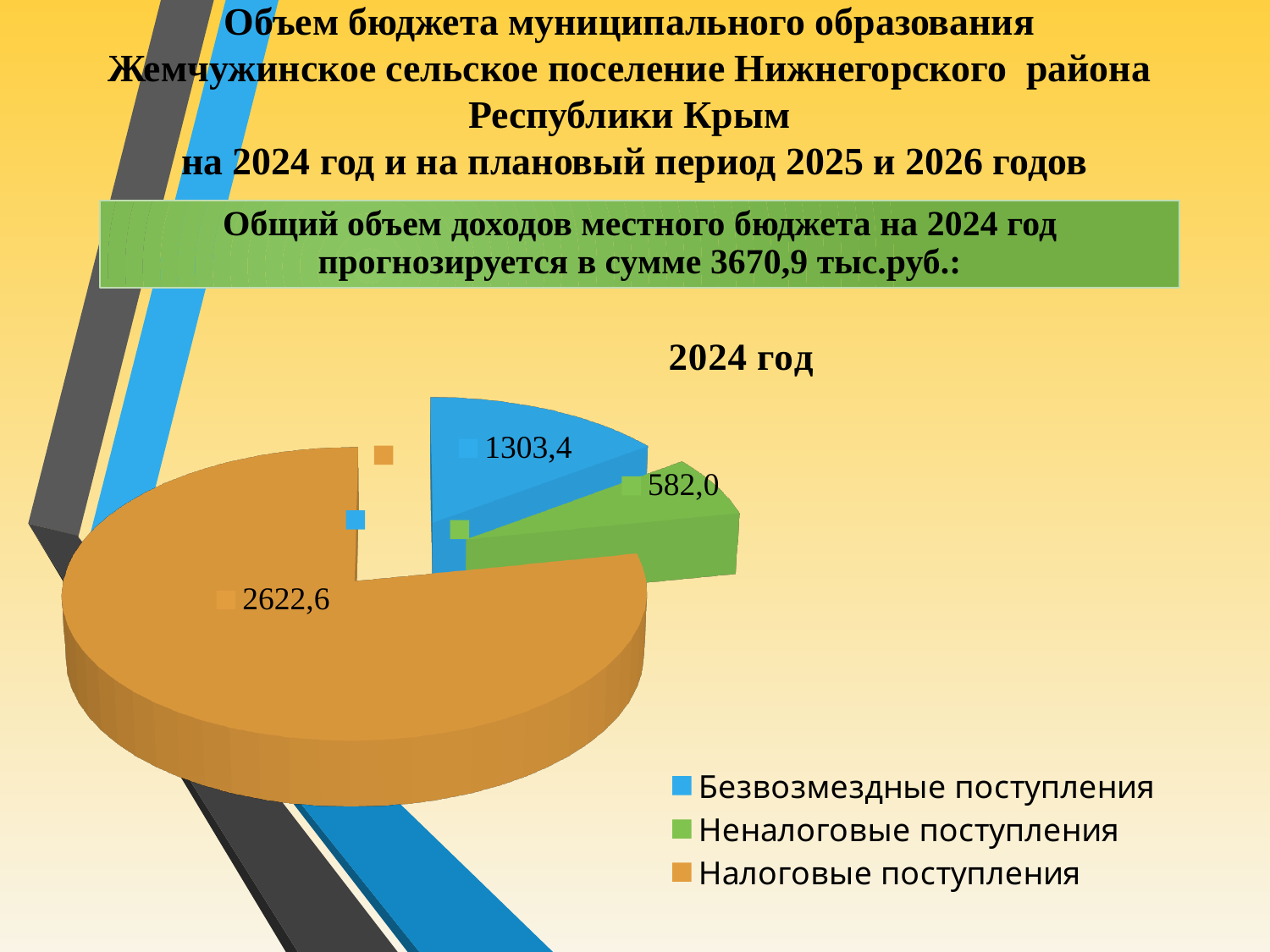
What is the difference between Налоговые поступления and Безвозмездные поступления? 1319,2 What is the value for Безвозмездные поступления? 1303,4 Which category has the smallest slice of the pie? Неналоговые поступления What colour is the slice for Неналоговые поступления? Green What is the value for Налоговые поступления? 2622,6 What is the difference between Безвозмездные поступления and Неналоговые поступления? 721,4 How many slices does the pie chart have? 3 Which is larger, Безвозмездные поступления or Неналоговые поступления? Безвозмездные поступления Which category has the largest slice of the pie? Налоговые поступления What type of chart is shown on the slide? Pie chart What is the title of the chart? 2024 год What is the value for Неналоговые поступления? 582,0